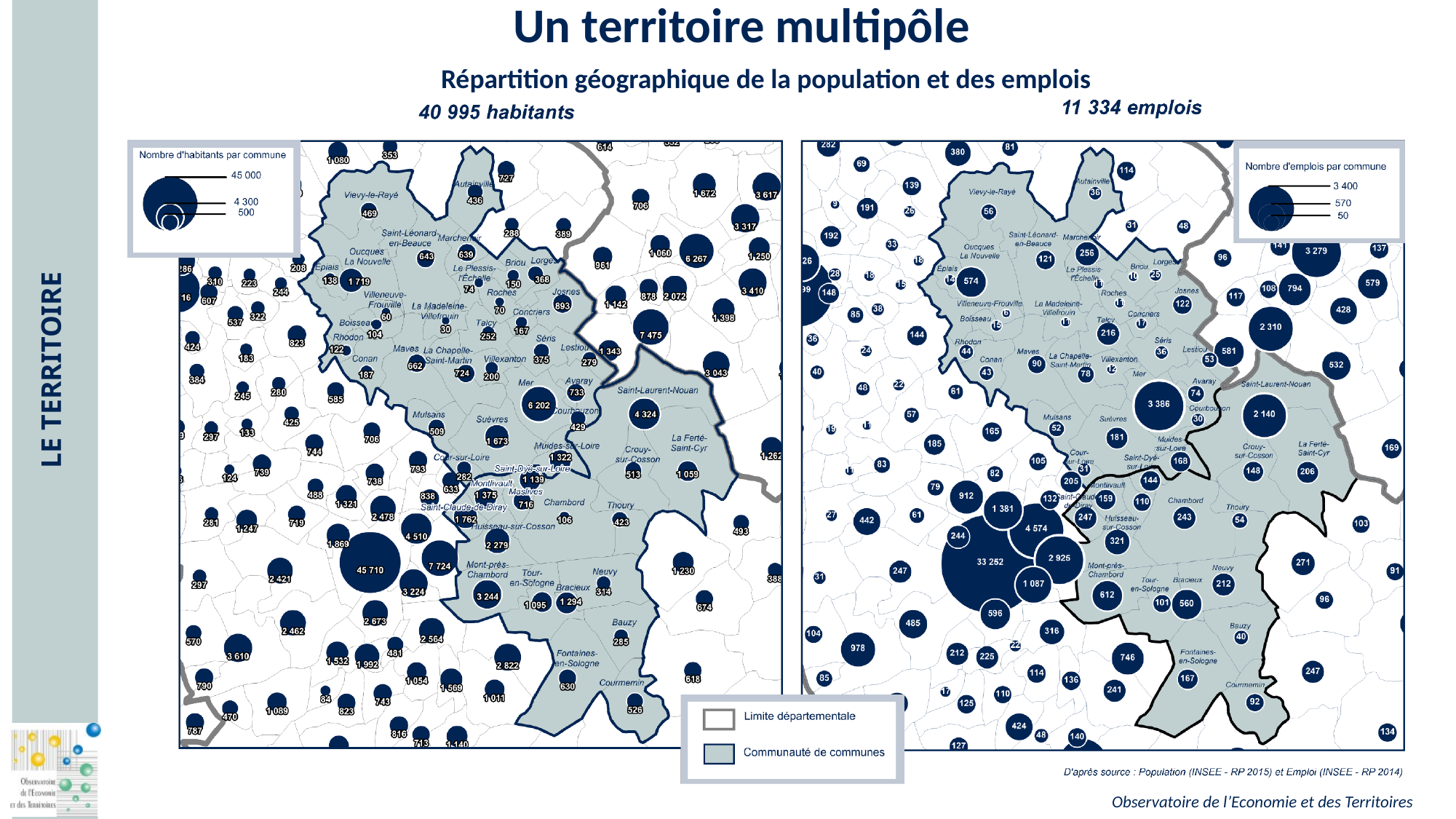
According to the subtitle above the left map, what is the total number of inhabitants? 40 995 habitants What is the largest value shown in the legend of the right map (Nombre d'emplois par commune)? 3 400 On the left map (Nombre d'habitants par commune), which commune inside the Communauté de communes has the largest number of inhabitants? Mer On the right map (Nombre d'emplois par commune), how many jobs are shown for Mer? 3 386 On the left map (Nombre d'habitants par commune), what is the difference in inhabitants between Mer and Saint-Laurent-Nouan? 1 878 On the left map (Nombre d'habitants par commune), how many inhabitants are shown for Mer? 6 202 On the right map (Nombre d'emplois par commune), how many jobs are shown for Saint-Laurent-Nouan? 2 140 On the left map (Nombre d'habitants par commune), how many inhabitants are shown for Saint-Laurent-Nouan? 4 324 What kind of chart is used on this slide to show population and jobs by commune? Proportional symbol (bubble) map On the right map (Nombre d'emplois par commune), which has more jobs, Mer or Saint-Laurent-Nouan? Mer On the left map (Nombre d'habitants par commune), how many inhabitants are shown for Mont-près-Chambord? 3 244 On the right map (Nombre d'emplois par commune), how many jobs are shown for Fontaines-en-Sologne? 167